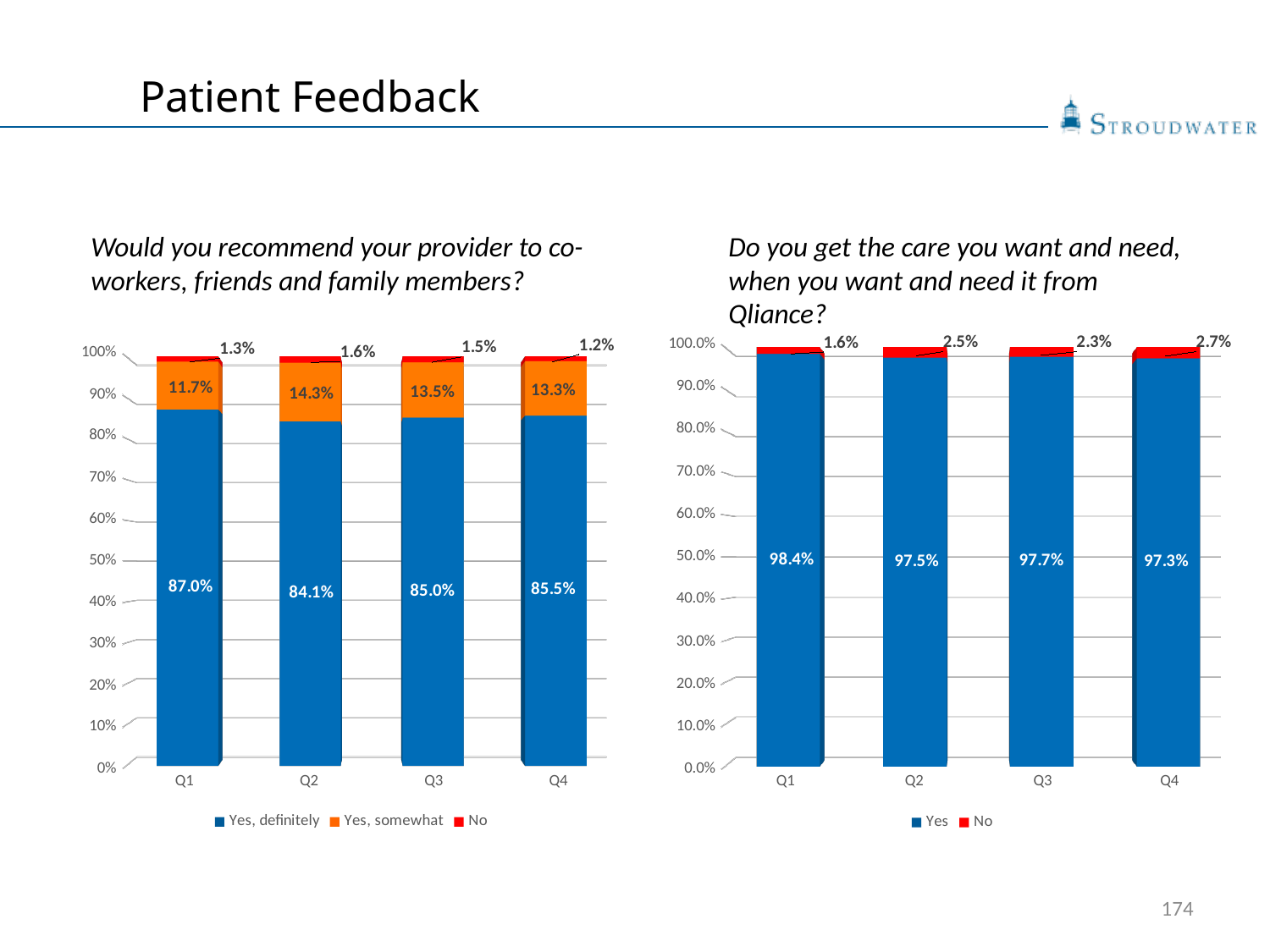
In the left chart (Would you recommend your provider), which quarter has the lowest 'No' value? Q4 In the right chart (Do you get the care you want and need), what is the difference between the 'No' values for Q4 and Q1? 1.1% In the right chart (Do you get the care you want and need), what is the 'Yes' value for Q3? 97.7% In the left chart (Would you recommend your provider), how many series does the legend list? 3 In the left chart (Would you recommend your provider), what is the difference between the 'Yes, definitely' values for Q1 and Q2? 2.9% In the right chart (Do you get the care you want and need), which quarter has the highest 'No' value? Q4 In the left chart (Would you recommend your provider), which quarter has the highest 'Yes, definitely' value? Q1 In the right chart (Do you get the care you want and need), is the 'Yes' value for Q2 larger or smaller than the 'Yes' value for Q4? larger In the left chart (Would you recommend your provider), what is the 'Yes, somewhat' value for Q2? 14.3% In the left chart (Would you recommend your provider), what is the 'Yes, definitely' value for Q1? 87.0% In the right chart (Do you get the care you want and need), how many quarters are shown on the x axis? 4 What type of chart is the left chart (Would you recommend your provider)? stacked bar chart